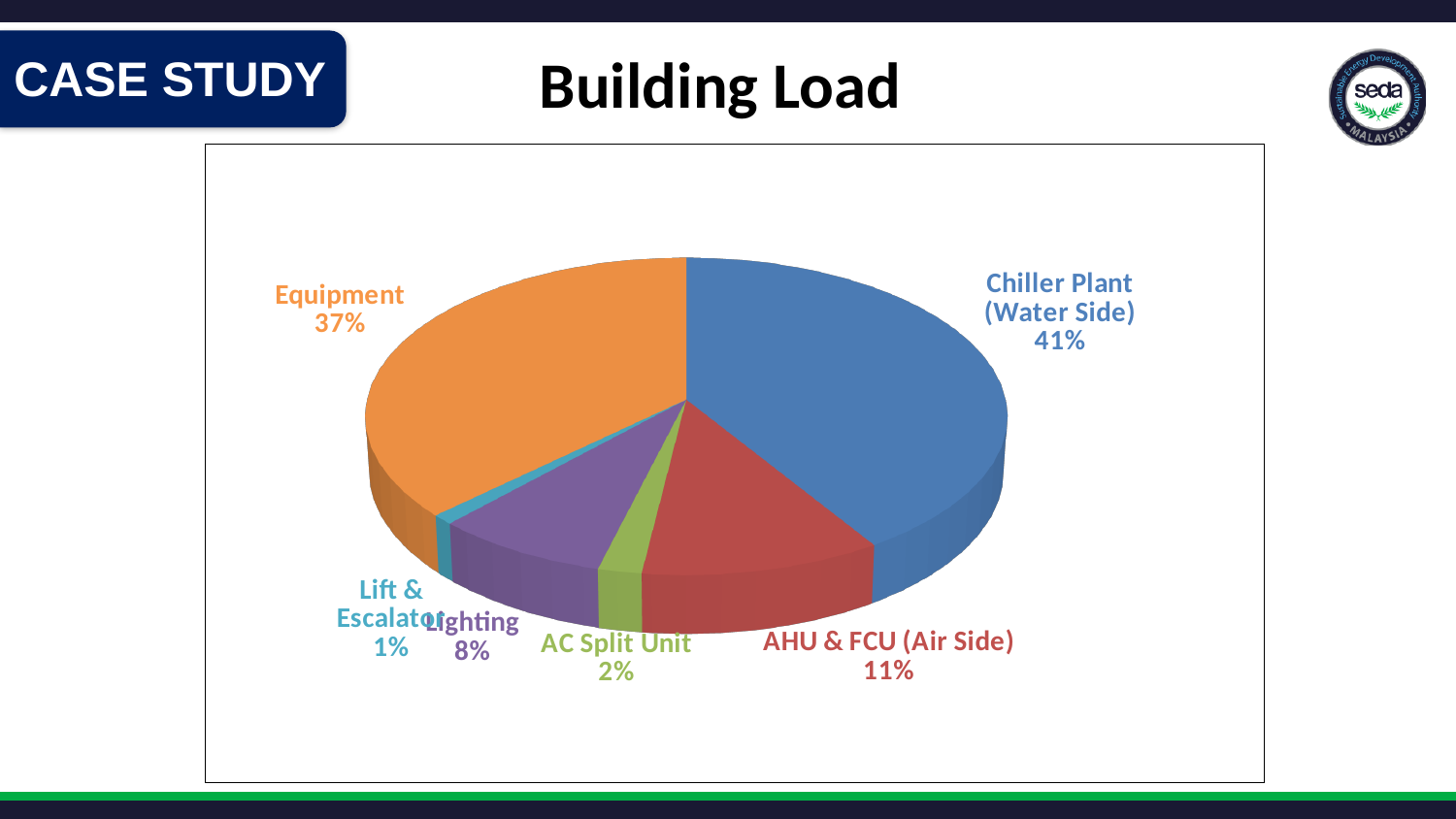
How many categories are shown in the pie chart? 6 What is the title of the chart on the slide? Building Load What share of the building load is AHU & FCU (Air Side)? 11% Which category has the smallest share of the building load? Lift & Escalator What share of the building load is Lighting? 8% What share of the building load is AC Split Unit? 2% What is the difference in percentage points between the Chiller Plant (Water Side) and Equipment shares? 4 What share of the building load is the Chiller Plant (Water Side)? 41% Which category has the largest share of the building load? Chiller Plant (Water Side) What kind of chart is shown on the slide? Pie chart Which is larger, the share for AHU & FCU (Air Side) or the share for Lighting? AHU & FCU (Air Side) What share of the building load is Equipment? 37%